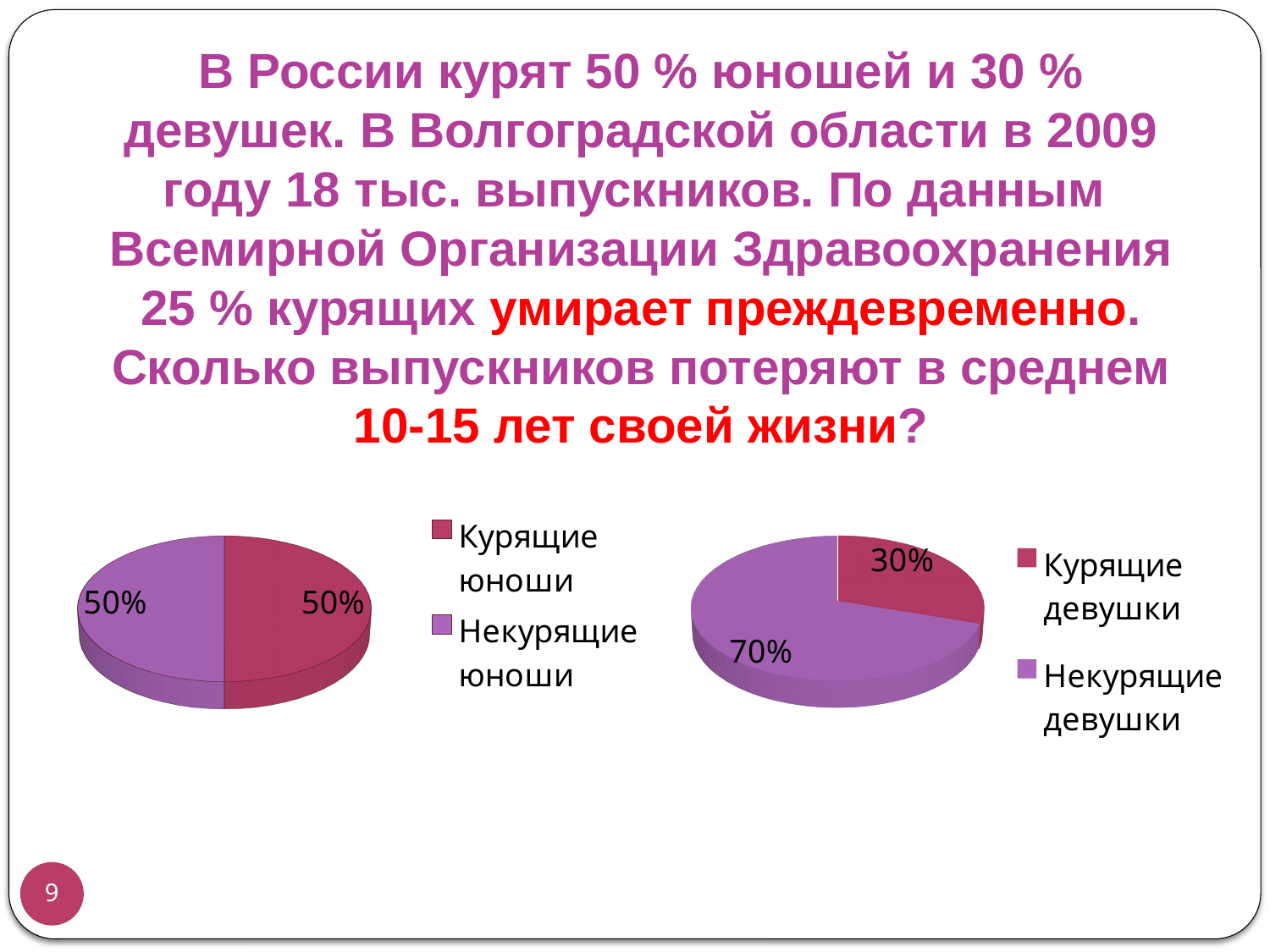
In the right pie chart, what share is shown for Некурящие девушки? 70% What kind of chart is the chart on the left of the slide? Pie chart In the right pie chart, which is larger: Курящие девушки or Некурящие девушки? Некурящие девушки In the right pie chart, which slice is the smallest? Курящие девушки In the left pie chart, what share is shown for Некурящие юноши? 50% In the right pie chart, what share is shown for Курящие девушки? 30% In the left pie chart, what colour is the slice for Курящие юноши? Dark pink (magenta) How many entries does the legend of the right pie chart list? 2 In the right pie chart, what is the difference between the shares for Некурящие девушки and Курящие девушки? 40% How many slices does the left pie chart have? 2 In the left pie chart, what share is shown for Курящие юноши? 50% In the right pie chart, which slice is the largest? Некурящие девушки